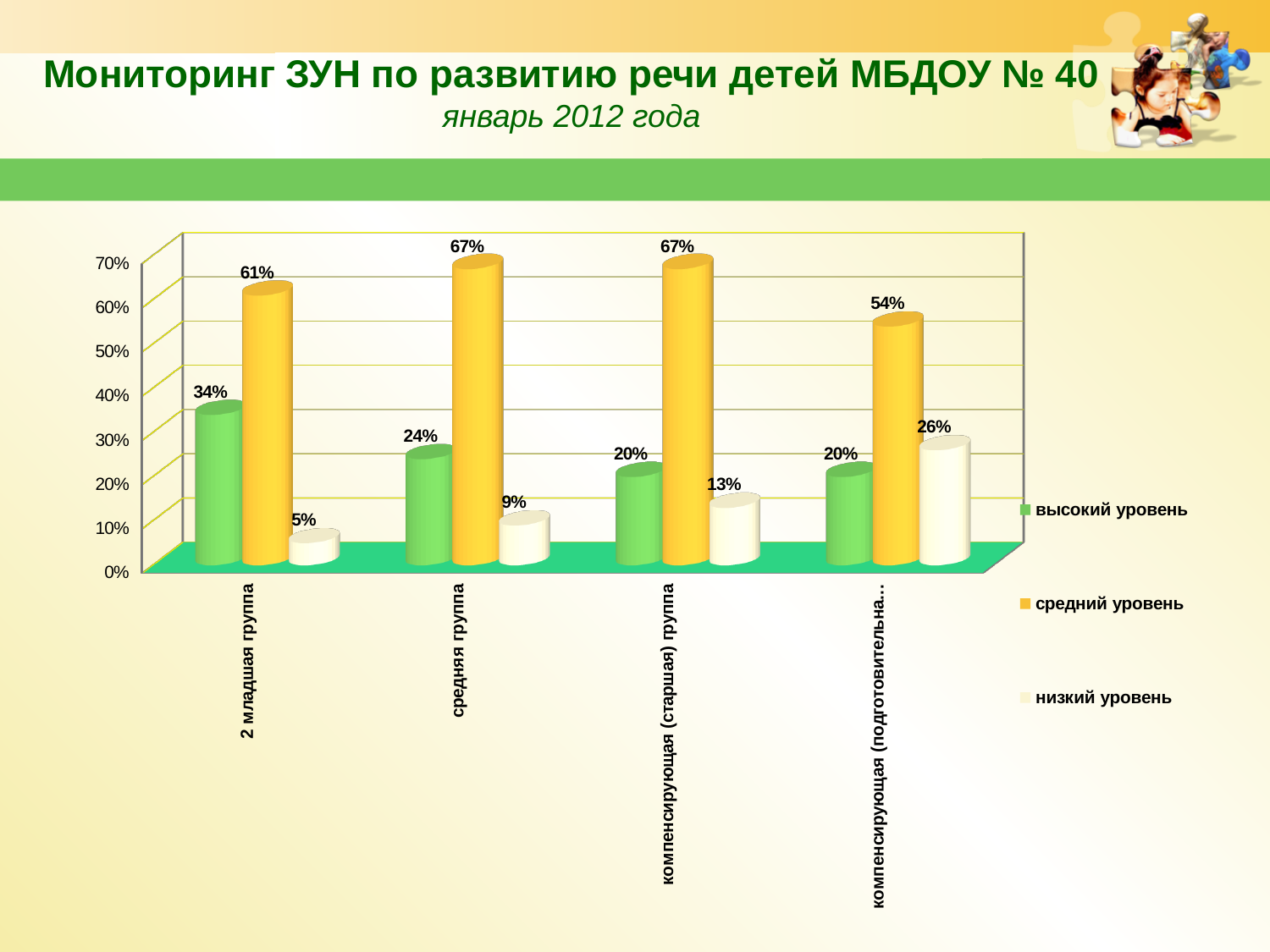
What is the value of "низкий уровень" for "компенсирующая (старшая) группа"? 13% Which series is shown in green in the legend? высокий уровень What is the value of "высокий уровень" for "2 младшая группа"? 34% What type of chart is shown on the slide? bar chart How many groups (categories) are plotted along the x axis? 4 Which is larger for "компенсирующая (старшая) группа": "высокий уровень" or "низкий уровень"? высокий уровень Which group has the lowest value for "низкий уровень"? 2 младшая группа What is the value of "низкий уровень" for "2 младшая группа"? 5% Which group has the highest value for "высокий уровень"? 2 младшая группа What is the value of "средний уровень" for "средняя группа"? 67% How many series does the legend list? 3 What is the difference between "средний уровень" and "высокий уровень" for "средняя группа"? 43%